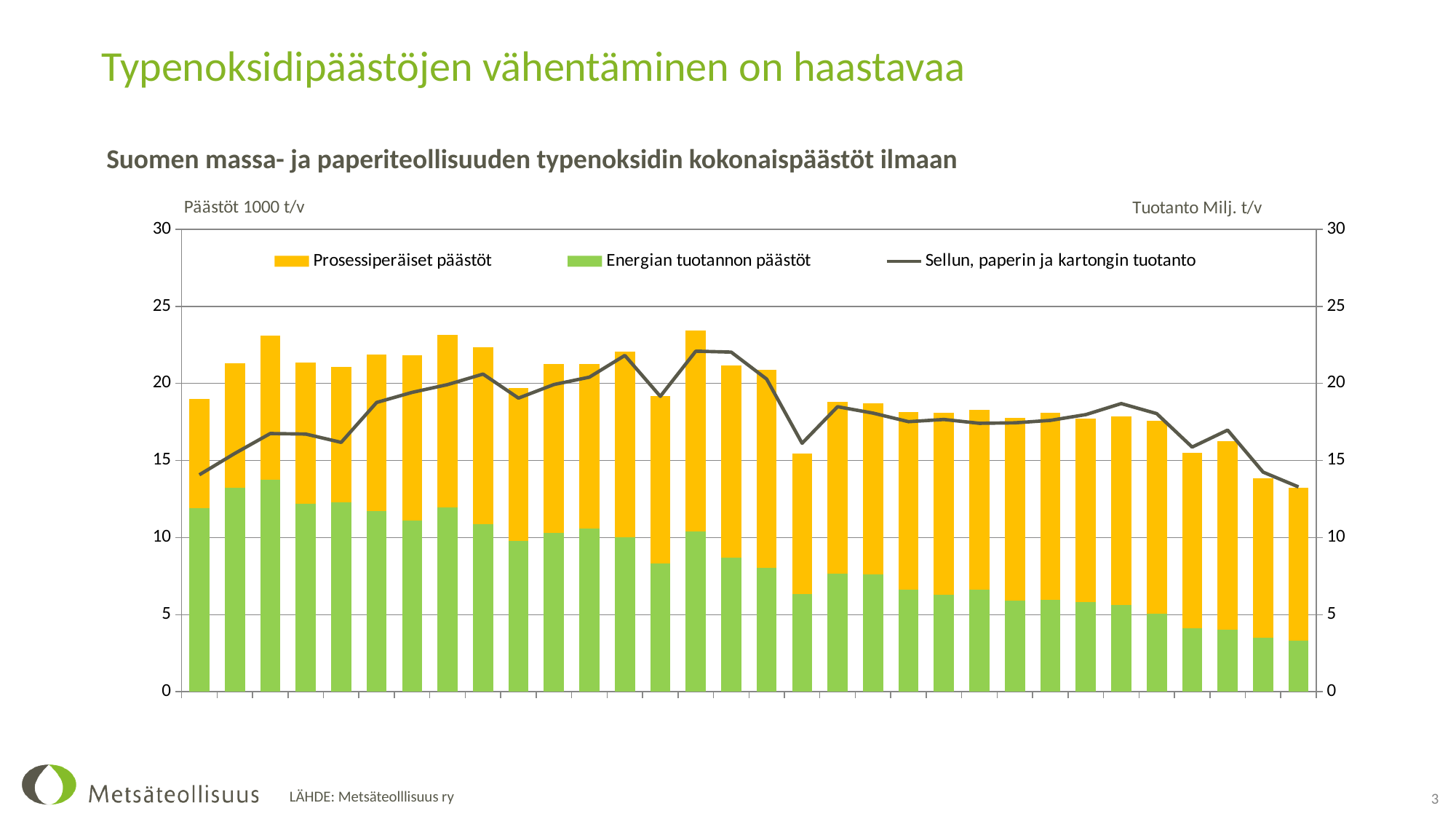
Which colour represents Energian tuotannon päästöt in the chart? Green What is the label of the left vertical axis? Päästöt 1000 t/v Is the total of the leftmost stacked bar greater or less than 15? greater What kind of chart is shown on the slide? A stacked bar chart with a line overlay Do the total stacked bar values generally rise or fall from left to right across the chart? Fall Is the green (Energian tuotannon päästöt) portion of the leftmost bar greater or less than 10? greater What is the title of the chart? Suomen massa- ja paperiteollisuuden typenoksidin kokonaispäästöt ilmaan Which series is plotted as a line rather than bars? Sellun, paperin ja kartongin tuotanto What is the label of the right vertical axis? Tuotanto Milj. t/v How many series does the legend list? 3 Is the total of the rightmost stacked bar greater or less than 15? less What is the maximum value shown on the left vertical axis? 30